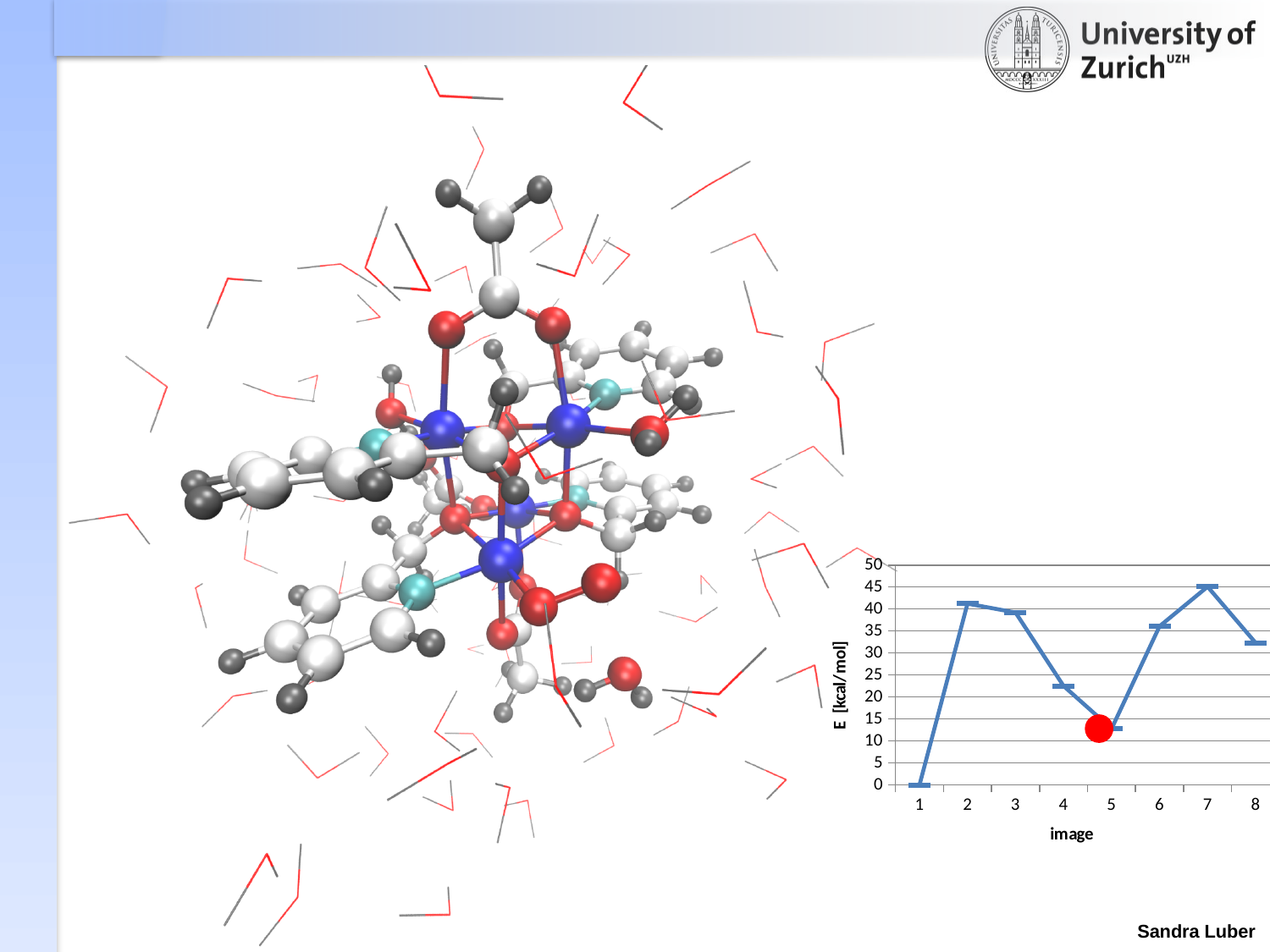
Which image has the highest energy value? 7 Is the value for image 8 greater or less than 25? greater How many data points are plotted on the chart? 8 Is the value for image 2 greater or less than 35? greater Which has the larger energy value, image 2 or image 5? image 2 What is the title of the x axis of the chart? image Do the values rise or fall from image 2 to image 5? fall What kind of chart is shown on the slide? line chart Is the value for image 5 greater or less than 20? less What is the title of the y axis of the chart? E [kcal/mol] Which image has the lowest energy value? 1 What is the energy value for image 1? 0